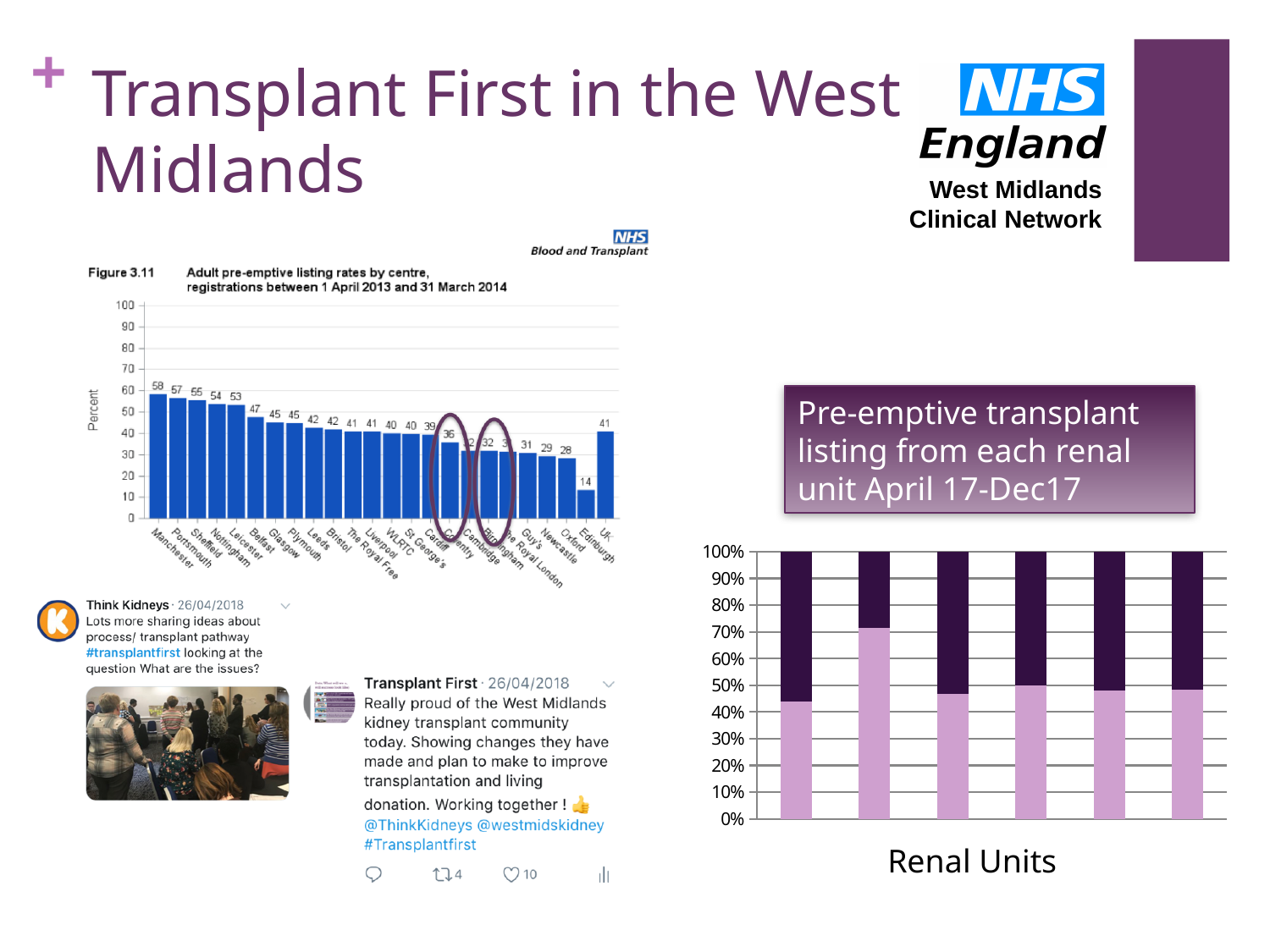
In the Figure 3.11 chart, do the values generally rise or fall from left to right across the centres (excluding the UK bar)? fall In the Figure 3.11 chart, what is the adult pre-emptive listing rate for Manchester? 58 In the Figure 3.11 chart, what is the value shown for the UK bar? 41 How many bars are plotted in the 'Pre-emptive transplant listing from each renal unit April 17-Dec17' chart? 6 In the Figure 3.11 chart, which centre has the lowest pre-emptive listing rate? Edinburgh What is the x-axis title of the 'Pre-emptive transplant listing from each renal unit April 17-Dec17' chart? Renal Units In the Figure 3.11 chart, which centre has the highest pre-emptive listing rate? Manchester In the Figure 3.11 chart, what is the difference between the values for Manchester and Edinburgh? 44 In the Figure 3.11 chart, what is the value shown for Coventry? 36 In the Figure 3.11 chart, which has the higher value, Belfast or Oxford? Belfast What kind of chart is the 'Pre-emptive transplant listing from each renal unit April 17-Dec17' chart? stacked bar chart In the 'Pre-emptive transplant listing from each renal unit April 17-Dec17' chart, is the light purple segment of the second bar greater or less than 60%? greater